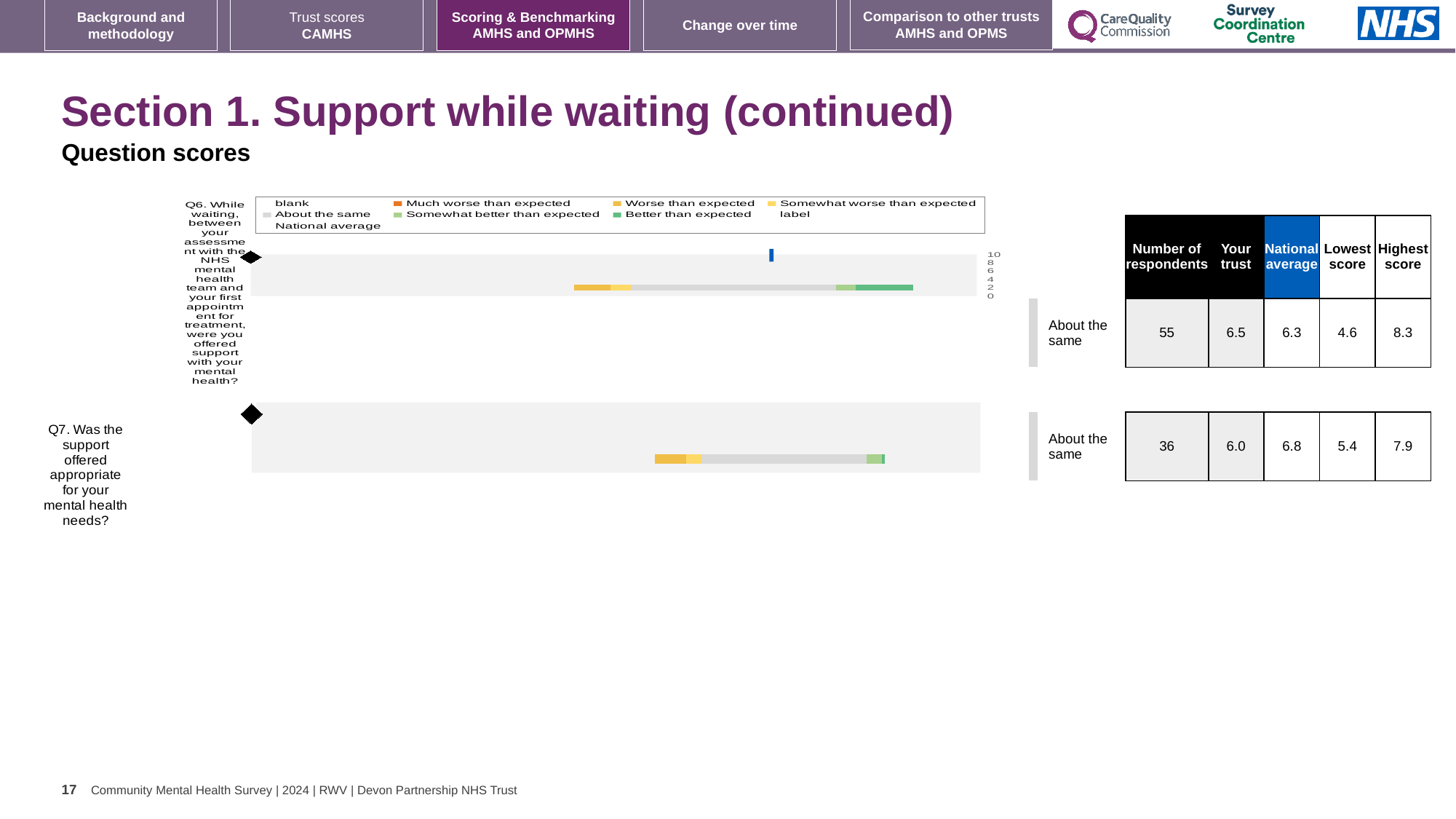
What is the national average score for Q7? 6.8 For Q6, which is larger: the trust's score or the national average? Your trust (6.5) What benchmark category is the trust's Q7 score placed in? About the same How many respondents answered Q6 (support while waiting between assessment and first appointment)? 55 What is the difference between the highest score and the lowest score for Q6? 3.7 How many respondents answered Q7 (was the support offered appropriate for your mental health needs)? 36 For Q7, which is larger: the trust's score or the national average? National average (6.8) What is the difference between the national average and the trust score for Q7? 0.8 What is the highest score shown for Q6? 8.3 What is the 'Your trust' score for Q6? 6.5 What is the lowest score shown for Q7? 5.4 How many questions are charted on this slide? 2